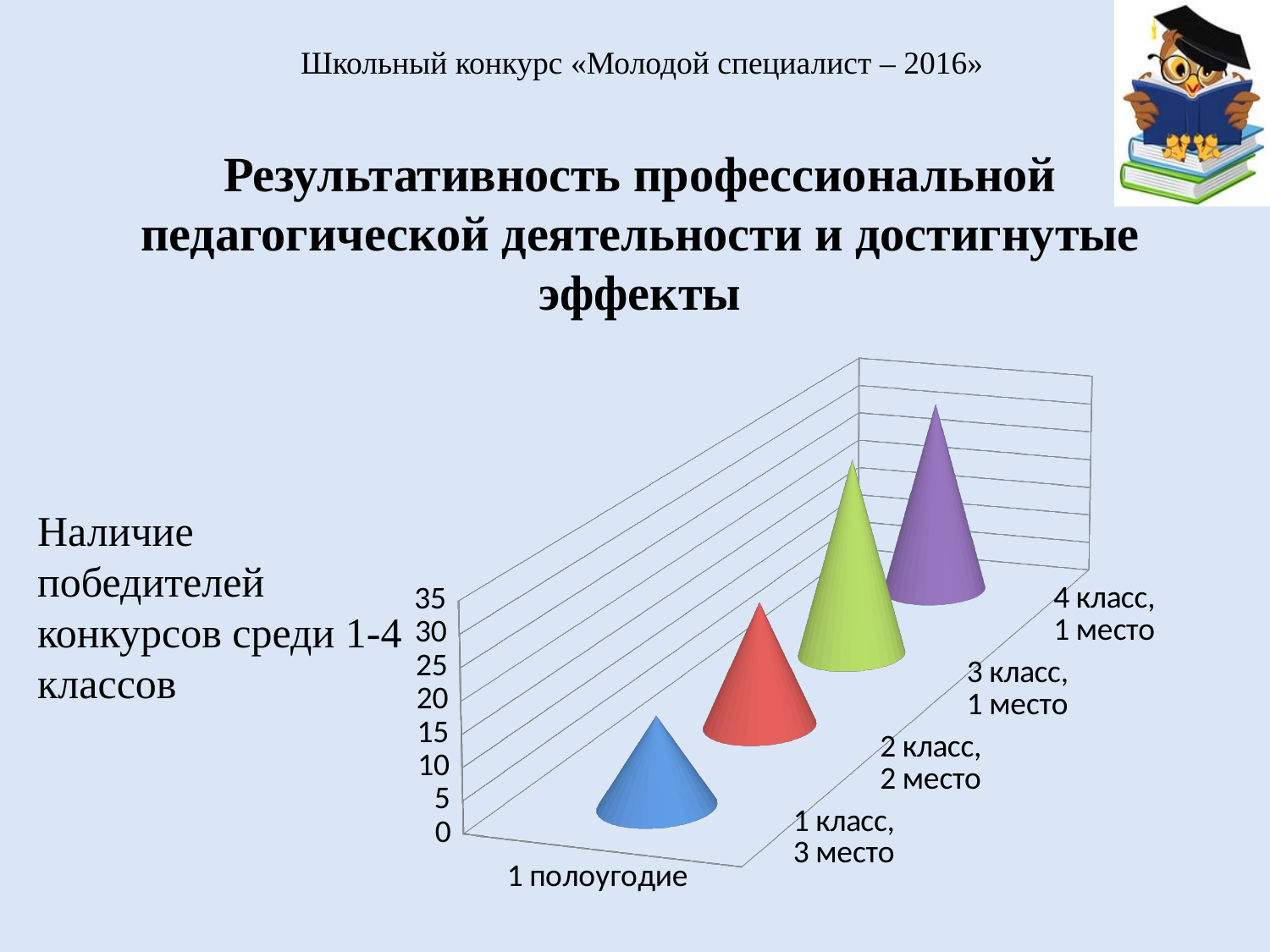
Is the value for "3 класс, 1 место" greater or less than 20? greater How many categories are shown on the x axis of the chart? 1 Which is larger: the value for "3 класс, 1 место" or the value for "2 класс, 2 место"? 3 класс, 1 место Which is larger: the value for "2 класс, 2 место" or the value for "1 класс, 3 место"? 2 класс, 2 место Is the value for "4 класс, 1 место" greater or less than 15? greater How many series does the chart's legend (category labels) list? 4 What kind of chart is shown on the slide? bar chart Which series has the lowest value in the chart? 1 класс, 3 место What colour is the cone for "4 класс, 1 место"? purple Is the value for "1 класс, 3 место" greater or less than 25? less What is the label of the single category on the x axis? 1 полоугодие